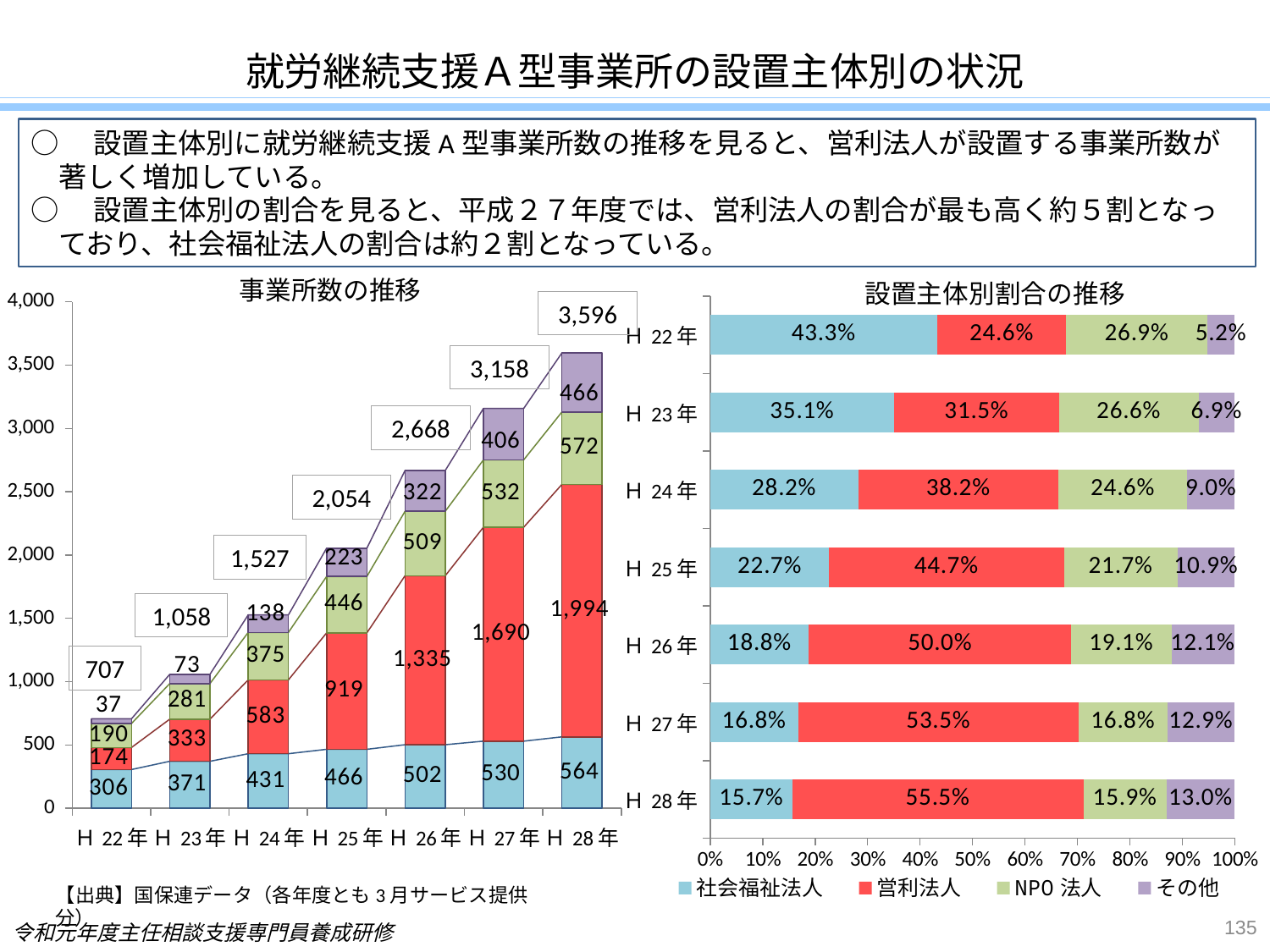
In the chart titled 事業所数の推移, do the totals rise or fall from H 22年 to H 28年? rise In the chart titled 設置主体別割合の推移, what is the share of 社会福祉法人 for H 22年? 43.3% In the chart titled 設置主体別割合の推移, how many series does the legend list? 4 In the chart titled 事業所数の推移, what is the total value shown for H 28年? 3,596 In the chart titled 事業所数の推移, how many years are shown on the x axis? 7 In the chart titled 事業所数の推移, what is the total value shown for H 22年? 707 In the chart titled 事業所数の推移, what is the difference between the totals for H 28年 and H 27年? 438 In the chart titled 設置主体別割合の推移, what is the share of 営利法人 for H 27年? 53.5% In the chart titled 設置主体別割合の推移, which is larger for H 24年: 社会福祉法人 or 営利法人? 営利法人 What kind of chart is the chart titled 設置主体別割合の推移? bar chart In the chart titled 設置主体別割合の推移, which year has the highest share for 営利法人? H 28年 In the chart titled 事業所数の推移, what is the value of the red segment for H 26年? 1,335